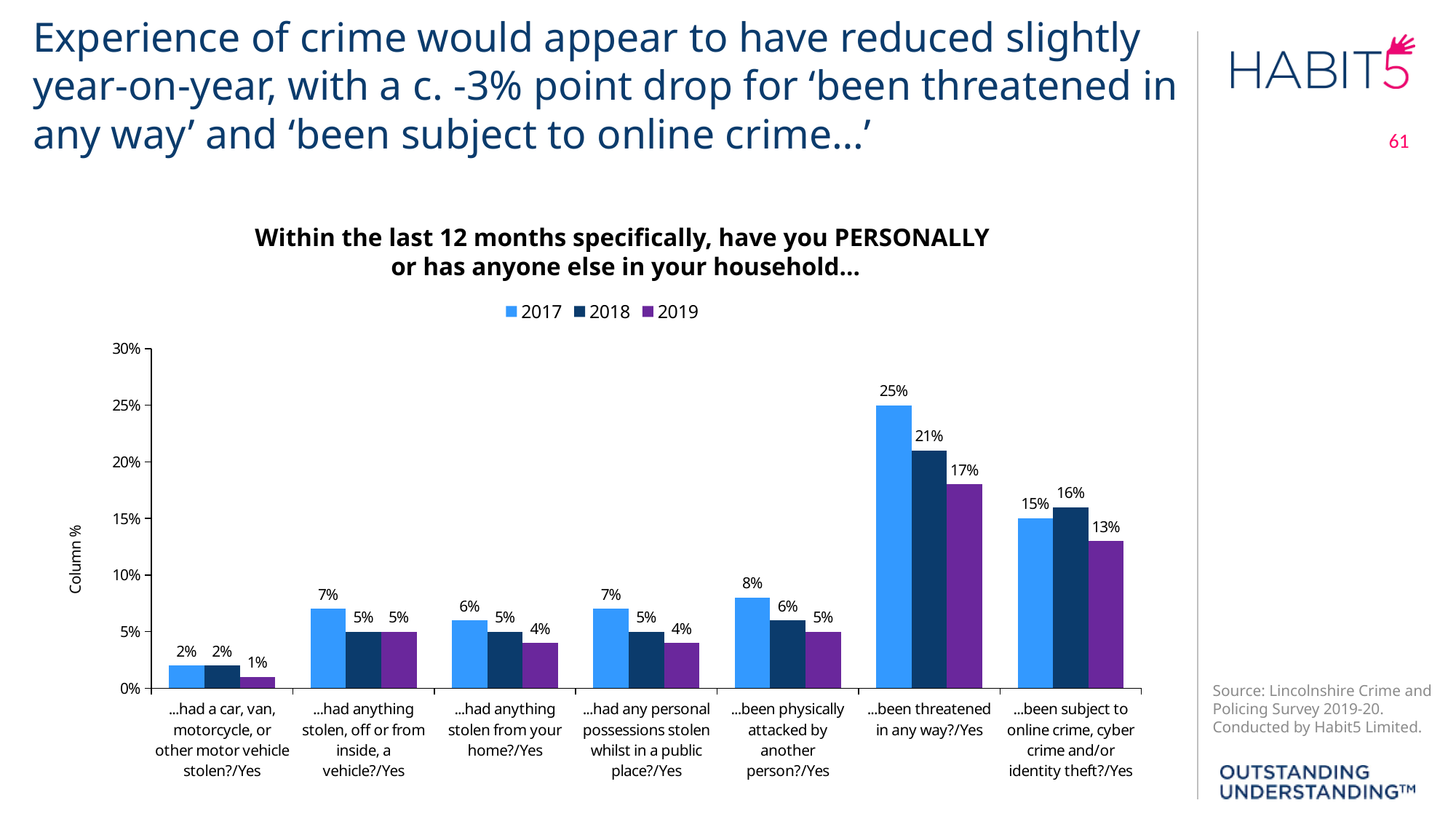
What is the difference between the 2017 and 2019 values for '...been threatened in any way?/Yes'? 8% How many categories are shown on the x axis? 7 What is the 2019 value for '...been threatened in any way?/Yes'? 17% Which category has the lowest 2019 value? ...had a car, van, motorcycle, or other motor vehicle stolen?/Yes What is the 2018 value for '...been physically attacked by another person?/Yes'? 6% What is the label on the y axis of the chart? Column % How many series does the legend list? 3 What kind of chart is shown on the slide? Bar chart Which category has the highest 2017 value? ...been threatened in any way?/Yes For '...been subject to online crime, cyber crime and/or identity theft?/Yes', which year has the larger value, 2018 or 2019? 2018 What is the 2017 value for '...been subject to online crime, cyber crime and/or identity theft?/Yes'? 15% Across 2017, 2018 and 2019, do the values for '...been threatened in any way?/Yes' rise or fall? Fall